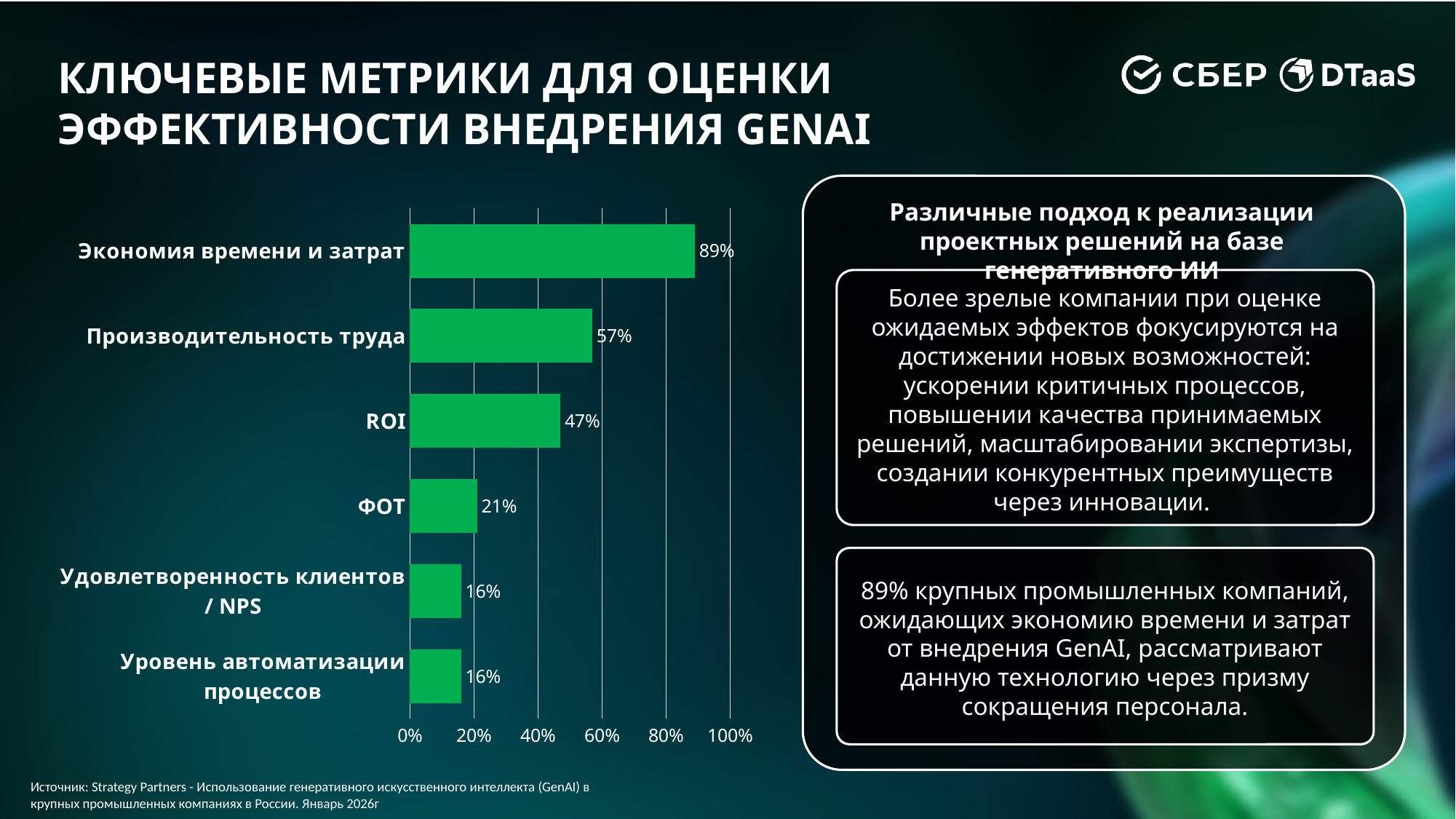
What kind of chart is shown on the slide? bar chart Which is larger, the value for Производительность труда or the value for ROI? Производительность труда How many categories are shown in the chart? 6 What is the value for Уровень автоматизации процессов? 16% What is the value for ФОТ? 21% What is the value for ROI? 47% What is the difference between the values for Экономия времени и затрат and Производительность труда? 32% Is the value for Экономия времени и затрат greater or less than 80%? greater Which category has the highest value? Экономия времени и затрат What is the difference between the values for ROI and ФОТ? 26% What is the value for Производительность труда? 57% What is the value for Экономия времени и затрат? 89%